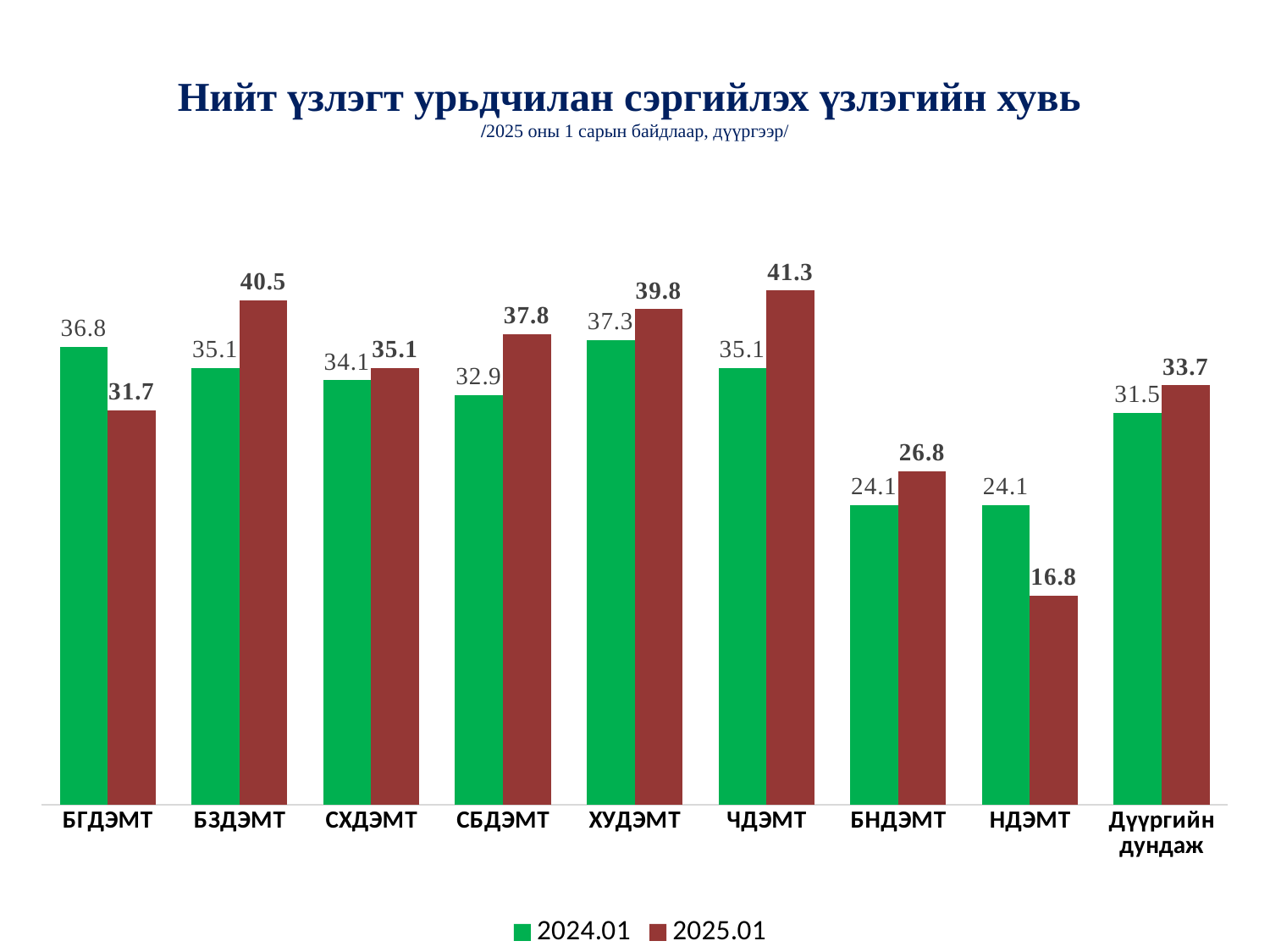
Which category has the highest 2025.01 value? ЧДЭМТ What kind of chart is shown on the slide? Bar chart Which category has the lowest 2025.01 value? НДЭМТ What is the difference between the 2024.01 and 2025.01 values for НДЭМТ? 7.3 What is the 2025.01 value for ЧДЭМТ? 41.3 How many series does the legend list? 2 For БГДЭМТ, which is larger: the 2024.01 value or the 2025.01 value? 2024.01 Which category has the highest 2024.01 value? ХУДЭМТ What is the difference between the 2025.01 and 2024.01 values for БЗДЭМТ? 5.4 What is the 2024.01 value for СБДЭМТ? 32.9 What is the 2025.01 value for Дүүргийн дундаж? 33.7 How many categories are shown on the x axis? 9